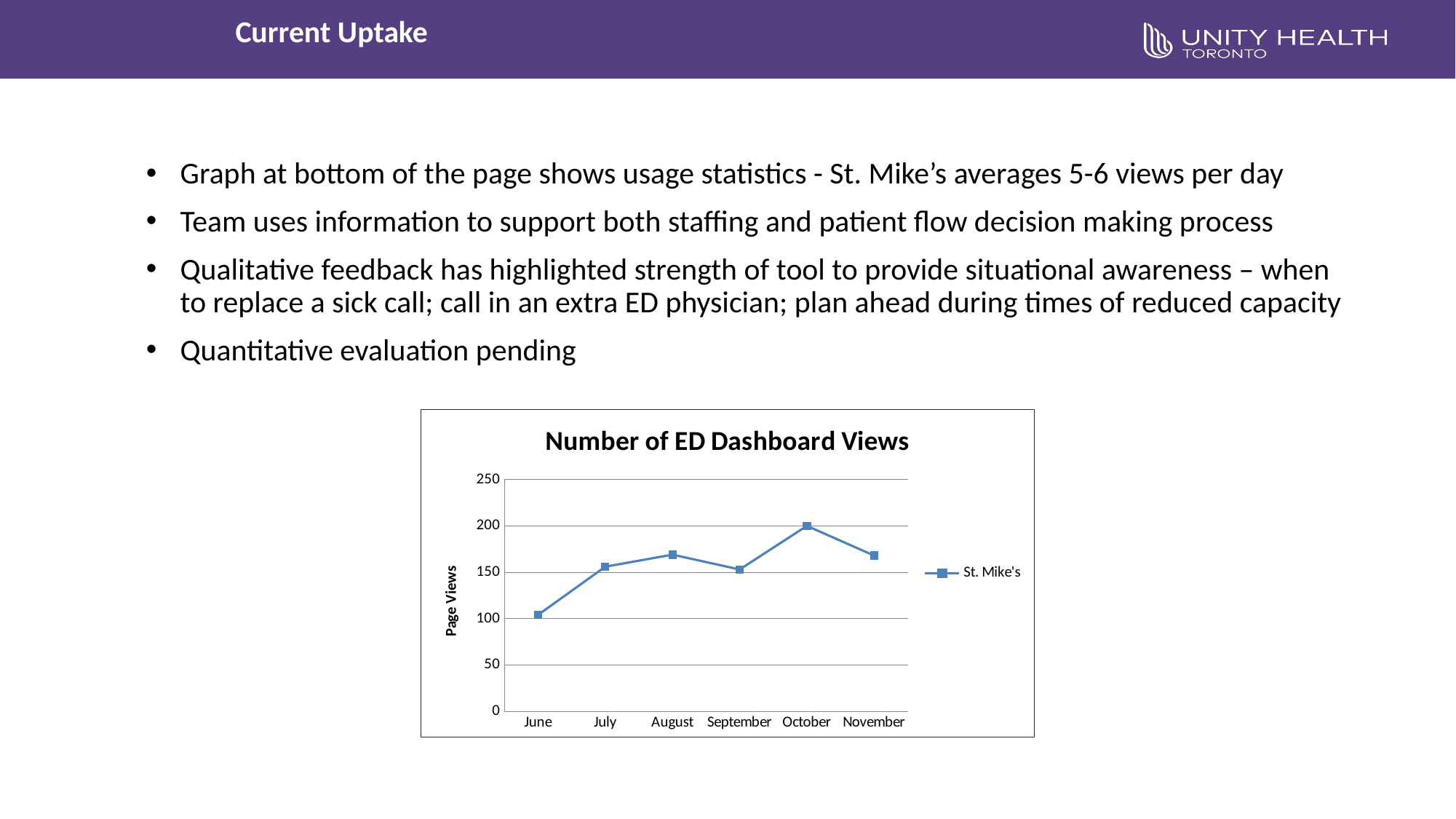
How many months are plotted along the x axis of the chart? 6 Do the page views rise or fall from June to July? Rise What is the title of the chart? Number of ED Dashboard Views Which month has the highest number of ED dashboard views? October Which month has the lowest number of ED dashboard views? June What kind of chart is shown on the slide? Line chart Is the value for August greater or less than 150? greater Is the value for November greater or less than 200? less Which month has more page views, October or November? October How many series does the chart's legend list? 1 Which month has more page views, June or July? July Is the value for June greater or less than 150? less